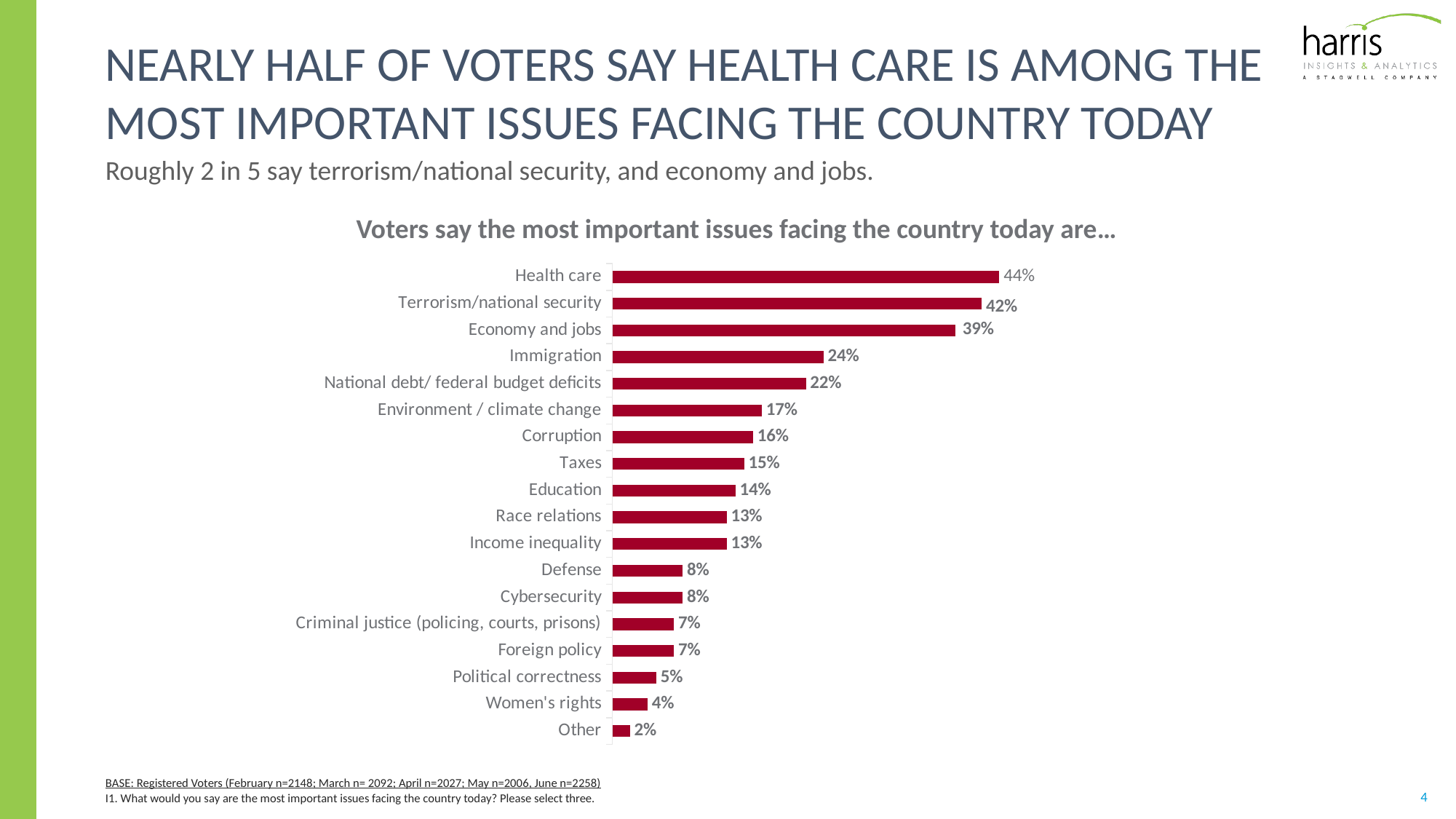
Which has a higher value, Corruption or Taxes? Corruption What type of chart is shown on the slide? Bar chart Which has a higher value, Political correctness or Women's rights? Political correctness What is the difference between the values for Health care and Economy and jobs? 5% What is the difference between the values for Immigration and National debt/ federal budget deficits? 2% Which issue has the highest percentage in the chart? Health care What percentage is shown for Environment / climate change? 17% What percentage of voters say health care is among the most important issues facing the country today? 44% Which category has the lowest value in the chart? Other What is the title of the chart? Voters say the most important issues facing the country today are... How many issue categories are shown in the chart? 18 What is the value shown for Immigration? 24%